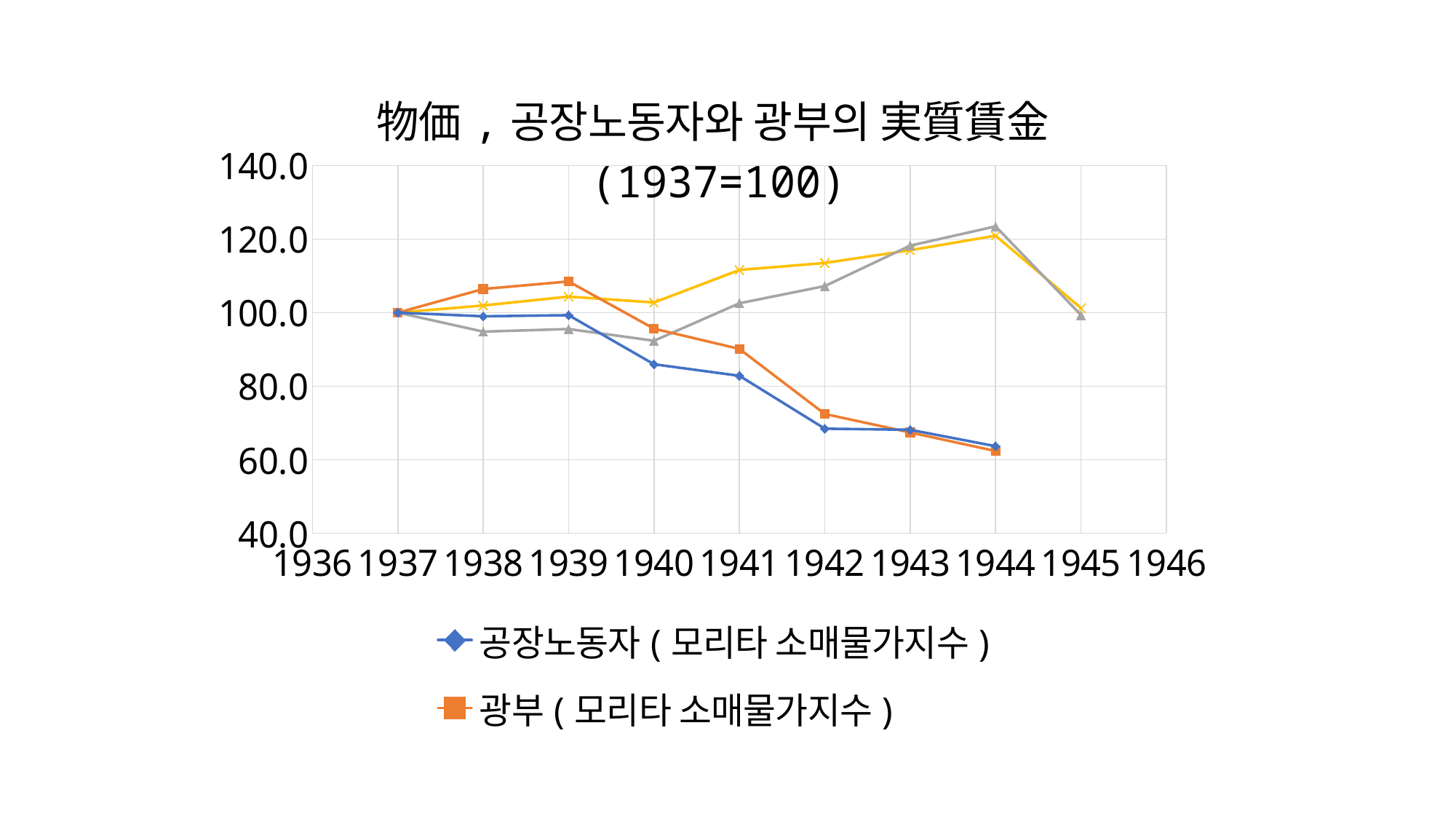
What kind of chart is shown on the slide? line chart What is the value for 광부 ( 모리타 소매물가지수 ) in 1937? 100.0 Is the value for 광부 ( 모리타 소매물가지수 ) in 1942 greater or less than 80.0? less How many series does the legend list? 2 In 1940, which is larger: 공장노동자 ( 모리타 소매물가지수 ) or 광부 ( 모리타 소매물가지수 )? 광부 ( 모리타 소매물가지수 ) In which year is 광부 ( 모리타 소매물가지수 ) at its highest? 1939 What is the value for 공장노동자 ( 모리타 소매물가지수 ) in 1937? 100.0 In which year is 공장노동자 ( 모리타 소매물가지수 ) at its lowest? 1944 Does the 공장노동자 ( 모리타 소매물가지수 ) series rise or fall from 1937 to 1944? fall Is the value for 광부 ( 모리타 소매물가지수 ) in 1939 greater or less than 100.0? greater Is the value for 공장노동자 ( 모리타 소매물가지수 ) in 1944 greater or less than 80.0? less What is the title of the chart? 物価，공장노동자와 광부의 実質賃金（1937=100）